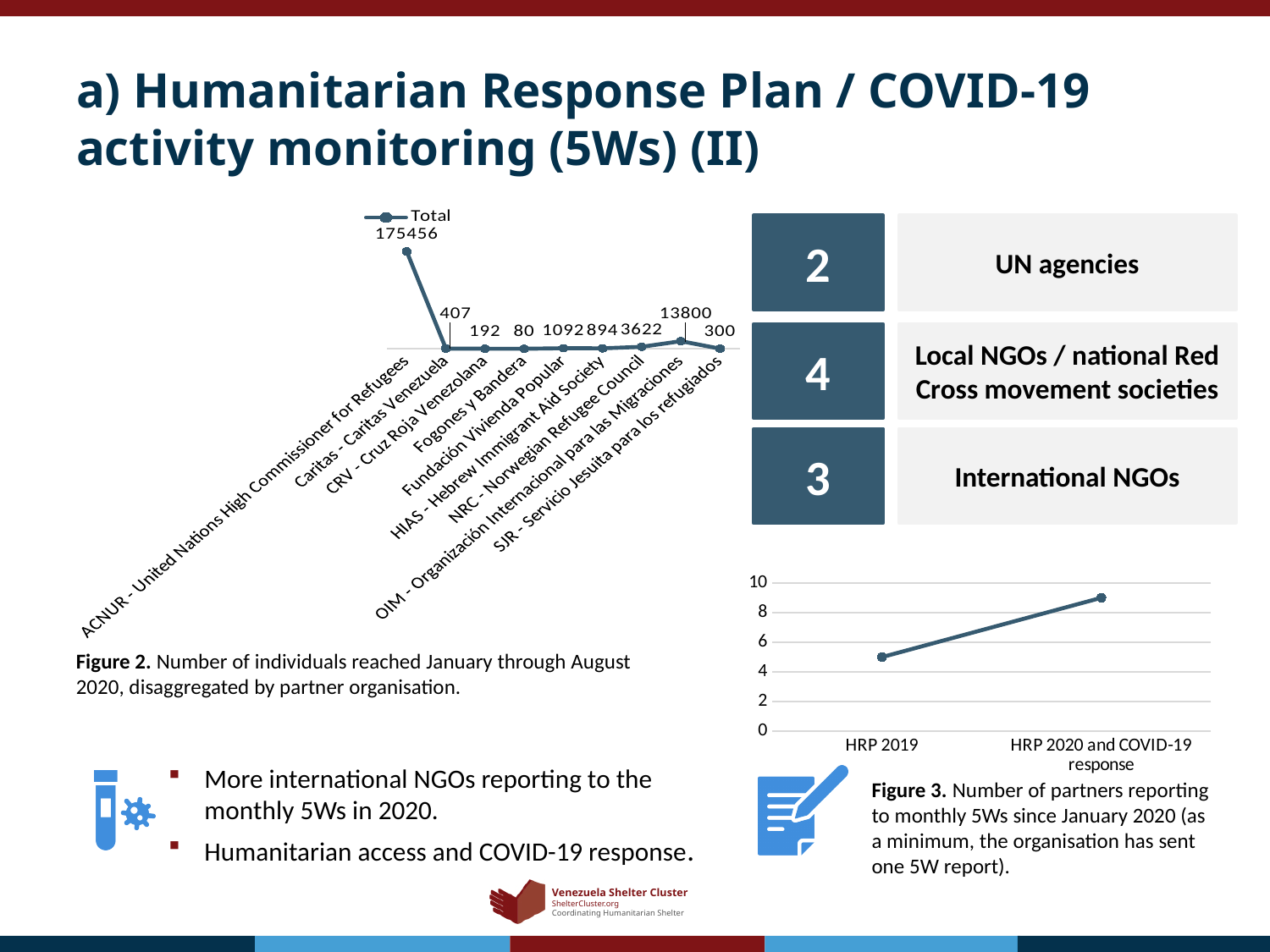
In Figure 3, is the value for HRP 2019 greater or less than 6? less In Figure 2, which partner organisation has the lowest number of individuals reached? Fogones y Bandera In Figure 2, what is the value for OIM - Organización Internacional para las Migraciones? 13800 In Figure 2, what is the difference between the values for Caritas - Caritas Venezuela and CRV - Cruz Roja Venezolana? 215 In Figure 2, how many individuals were reached by ACNUR - United Nations High Commissioner for Refugees? 175456 What series name does the legend of Figure 2 show? Total In Figure 2, which partner organisation has the highest number of individuals reached? ACNUR - United Nations High Commissioner for Refugees In Figure 3, is the value for HRP 2020 and COVID-19 response greater or less than 8? greater In Figure 2, which has a larger value: HIAS - Hebrew Immigrant Aid Society or Fundación Vivienda Popular? Fundación Vivienda Popular How many partner organisations are plotted in Figure 2? 9 In Figure 2, what is the value for NRC - Norwegian Refugee Council? 3622 In Figure 3, does the number of partners reporting rise or fall from HRP 2019 to HRP 2020 and COVID-19 response? rise